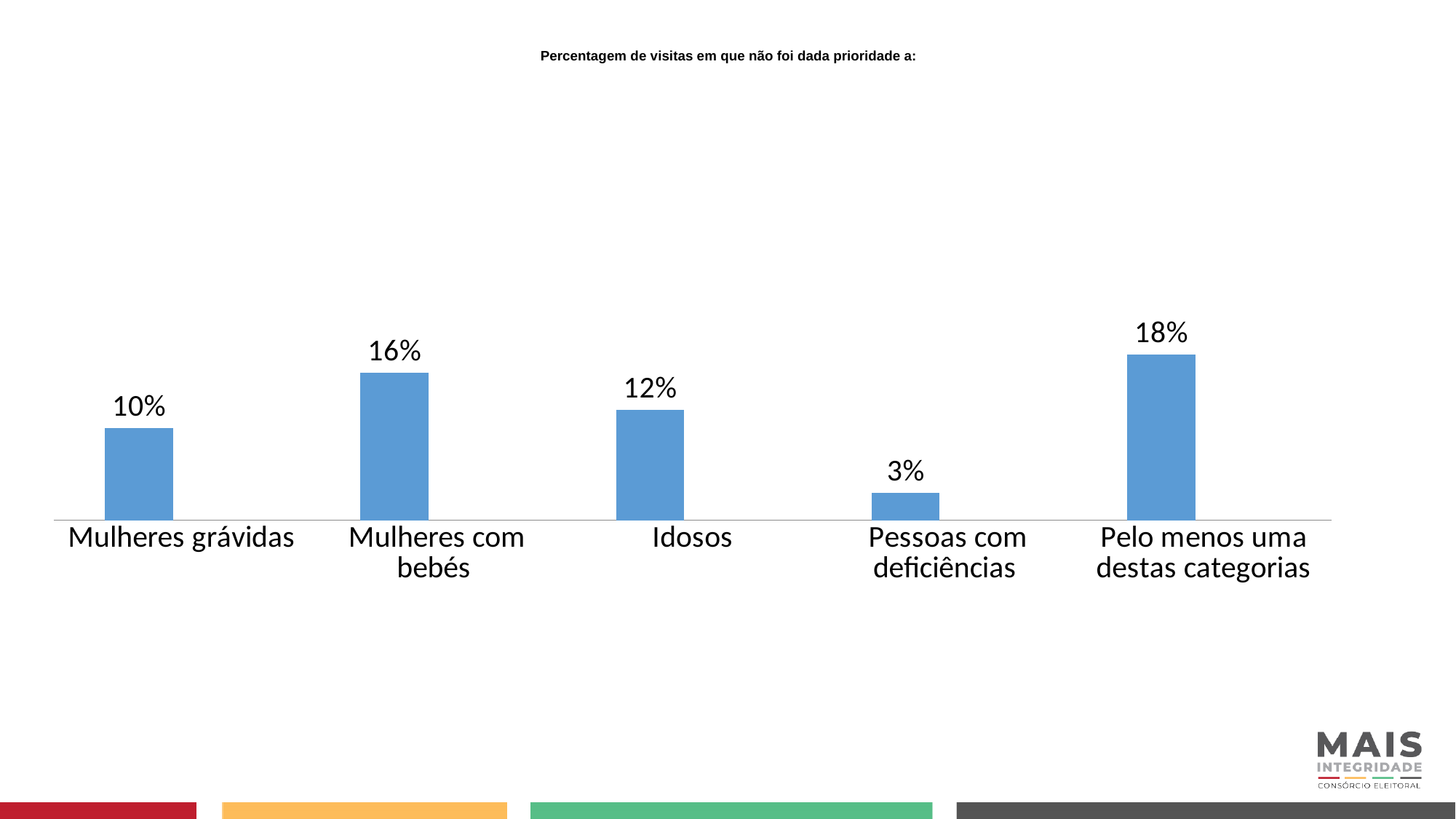
What is the title of the chart? Percentagem de visitas em que não foi dada prioridade a: What is the value for Mulheres com bebés? 16% What is the value for Idosos? 12% Which is larger, the value for Mulheres grávidas or the value for Idosos? Idosos What is the difference between the values for Mulheres com bebés and Idosos? 4% Which category has the highest value? Pelo menos uma destas categorias What is the value for Pelo menos uma destas categorias? 18% Which category has the lowest value? Pessoas com deficiências What is the value for Mulheres grávidas? 10% What kind of chart is shown on the slide? Bar chart How many categories are shown on the chart? 5 What is the value for Pessoas com deficiências? 3%